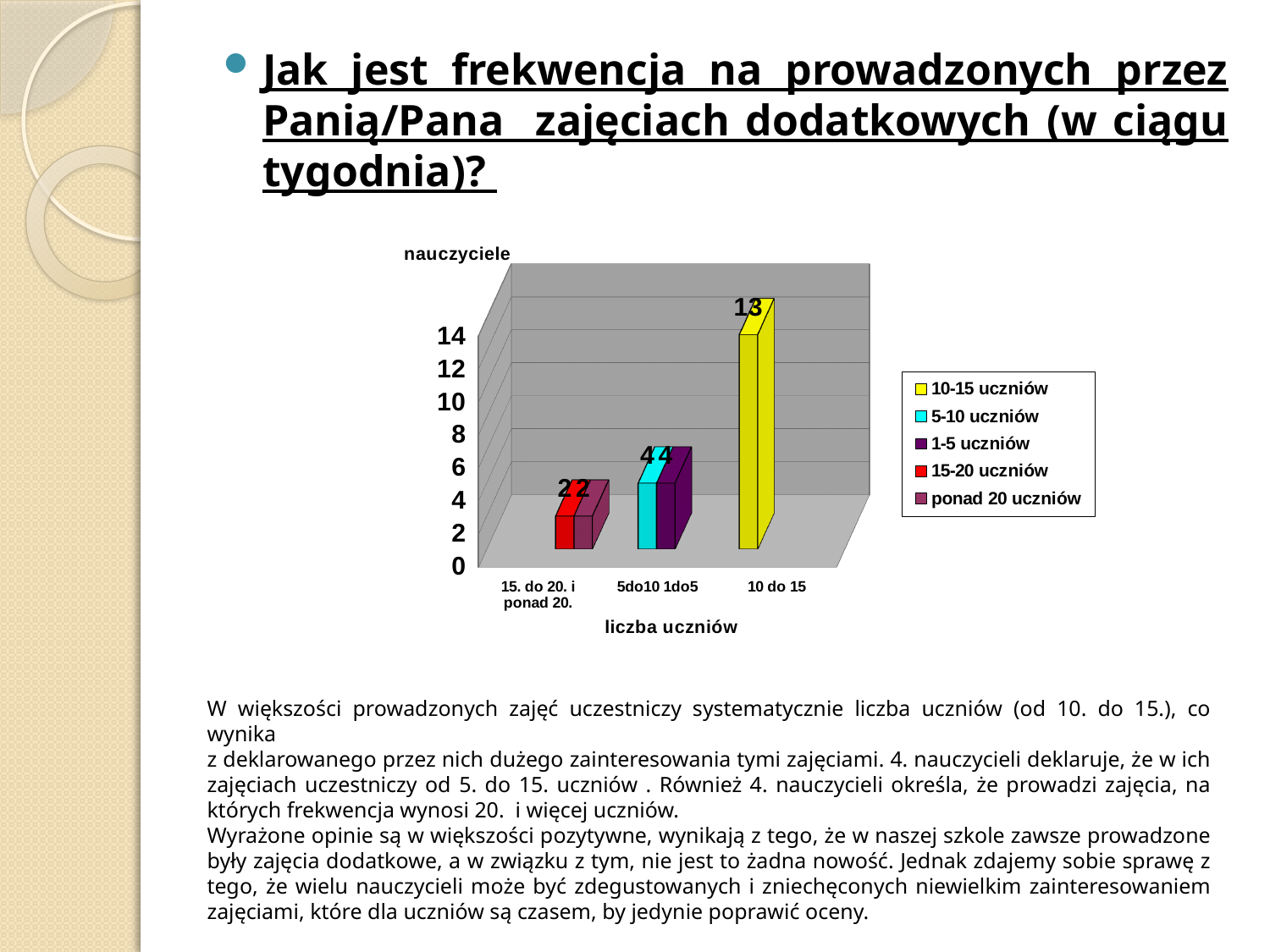
What is the difference between the value for 1-5 uczniów and the value for 15-20 uczniów? 2 Which series has the highest value in the chart? 10-15 uczniów Which is larger, the value for 10-15 uczniów or the value for 1-5 uczniów? 10-15 uczniów What value is shown for the 15-20 uczniów series? 2 What is the difference between the value for 10-15 uczniów and the value for 5-10 uczniów? 9 What value is shown for the ponad 20 uczniów series? 2 How many series does the legend list? 5 What is the title of the horizontal axis of the chart? liczba uczniów What value is shown for the 10-15 uczniów series? 13 What kind of chart is shown on the slide? bar chart What is the title of the vertical axis of the chart? nauczyciele What value is shown for the 5-10 uczniów series? 4